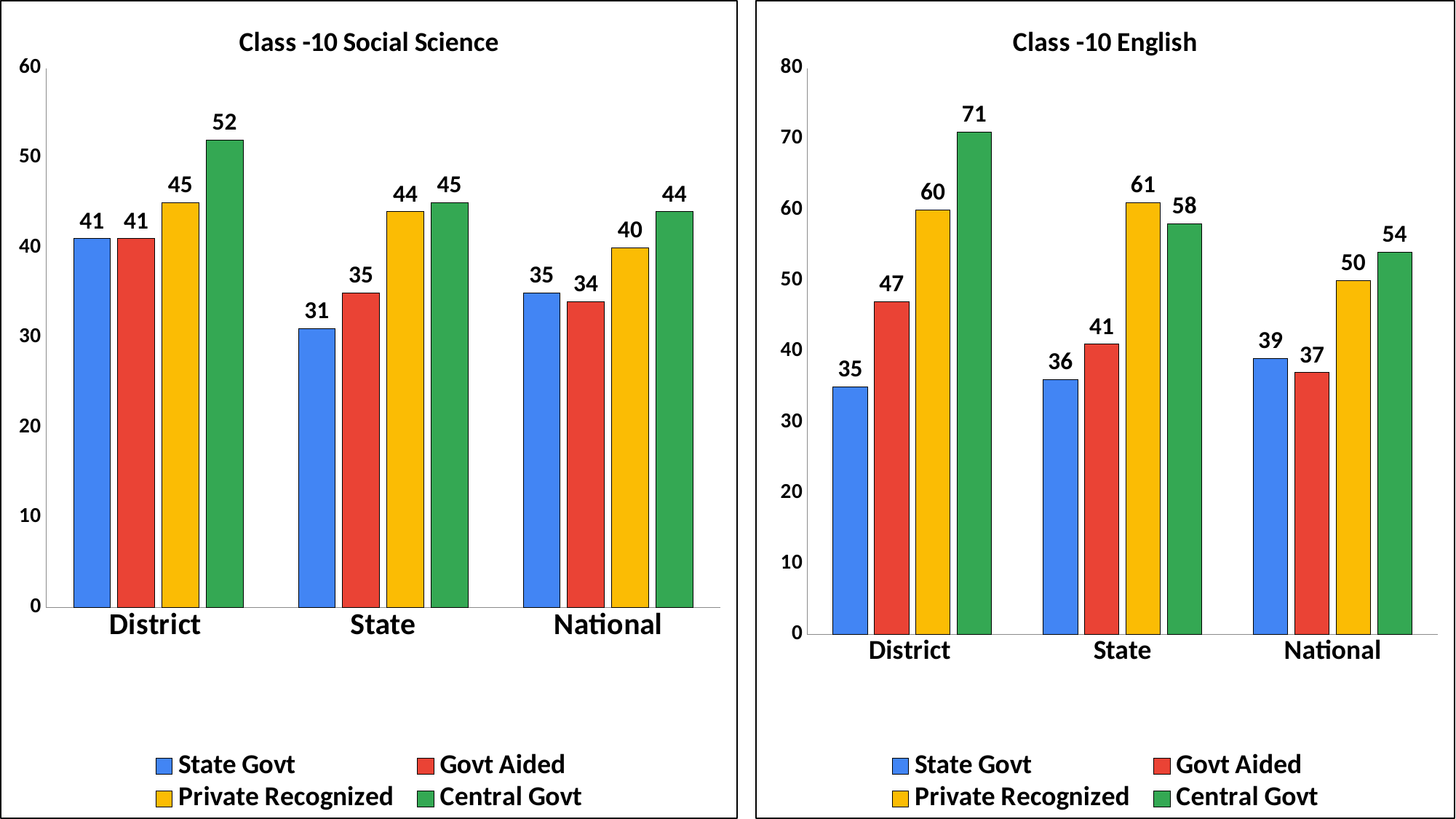
In the Class -10 Social Science chart, what is the value for Central Govt in the District category? 52 In the Class -10 Social Science chart, which school type has the lowest value in the State category? State Govt In the Class -10 Social Science chart, is the value for Central Govt in the District category greater or less than 50? greater How many series does the legend of the Class -10 Social Science chart list? 4 In the Class -10 Social Science chart, which colour represents Private Recognized? Yellow What kind of chart is the Class -10 English chart? Bar chart In the Class -10 English chart, which is larger in the State category: Private Recognized or Central Govt? Private Recognized In the Class -10 English chart, which school type has the highest value in the District category? Central Govt In the Class -10 English chart, what is the difference between Central Govt and State Govt in the District category? 36 In the Class -10 Social Science chart, what is the difference between Private Recognized and Govt Aided in the National category? 6 How many categories are shown on the x axis of the Class -10 English chart? 3 In the Class -10 English chart, what is the value for Private Recognized in the State category? 61